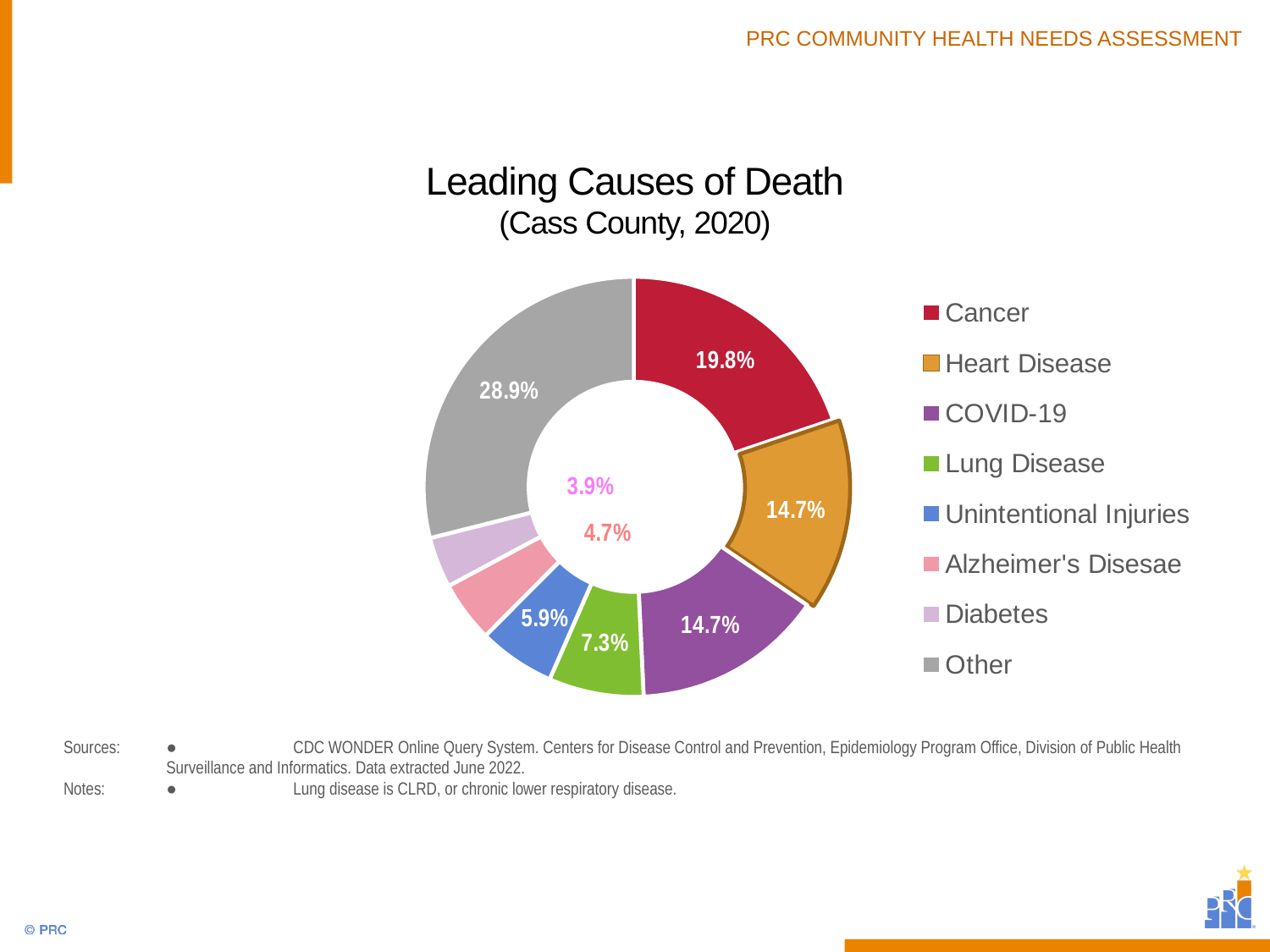
What percentage is shown for Unintentional Injuries? 5.9% What is the value for Diabetes? 3.9% Which is larger, the share for Lung Disease or the share for Unintentional Injuries? Lung Disease How many categories does the legend list? 8 What kind of chart is shown on the slide? Pie chart (donut) Which category has the smallest slice of the chart? Diabetes Which category has the largest slice of the chart? Other What share of deaths does the Other slice represent? 28.9% What is the value shown for Lung Disease? 7.3% What is the title of the chart? Leading Causes of Death (Cass County, 2020) What is the difference between the Cancer share and the Heart Disease share? 5.1% What percentage of deaths is attributed to Cancer? 19.8%